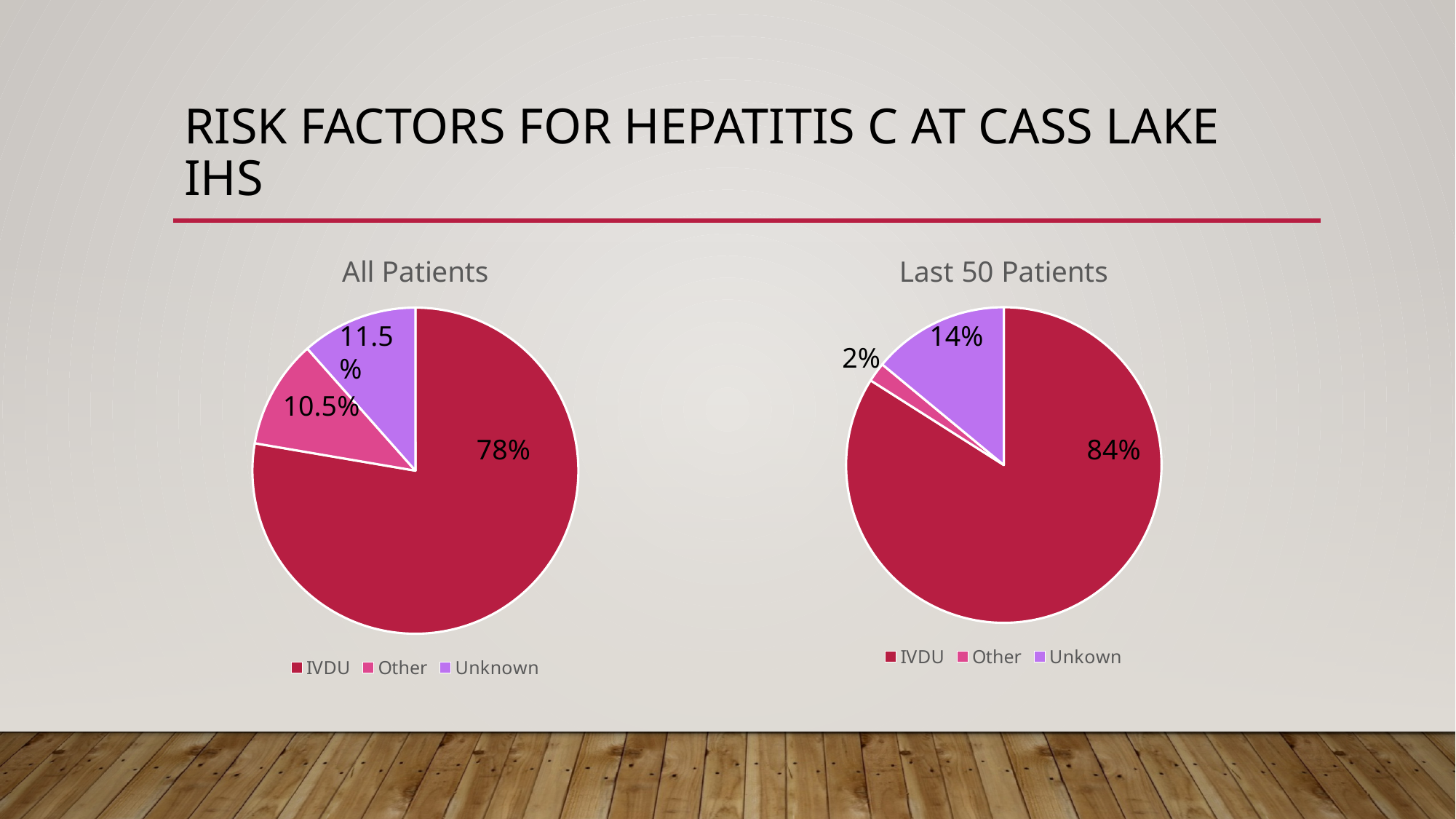
In the 'All Patients' chart, which category has the largest slice? IVDU What type of chart is the 'Last 50 Patients' chart? Pie chart In the 'All Patients' chart, what percentage is shown for Other? 10.5% In the 'Last 50 Patients' chart, which category has the smallest slice? Other In the 'All Patients' chart, which is larger, the Other slice or the Unknown slice? Unknown In the 'Last 50 Patients' chart, what percentage is shown for Other? 2% In the 'Last 50 Patients' chart, what percentage is shown for Unkown? 14% In the 'All Patients' chart, what percentage is shown for IVDU? 78% In the 'All Patients' chart, what percentage is shown for Unknown? 11.5% In the 'Last 50 Patients' chart, what percentage is shown for IVDU? 84% What is the difference between the IVDU percentage in the 'Last 50 Patients' chart and the IVDU percentage in the 'All Patients' chart? 6% How many categories does the legend of the 'All Patients' chart list? 3